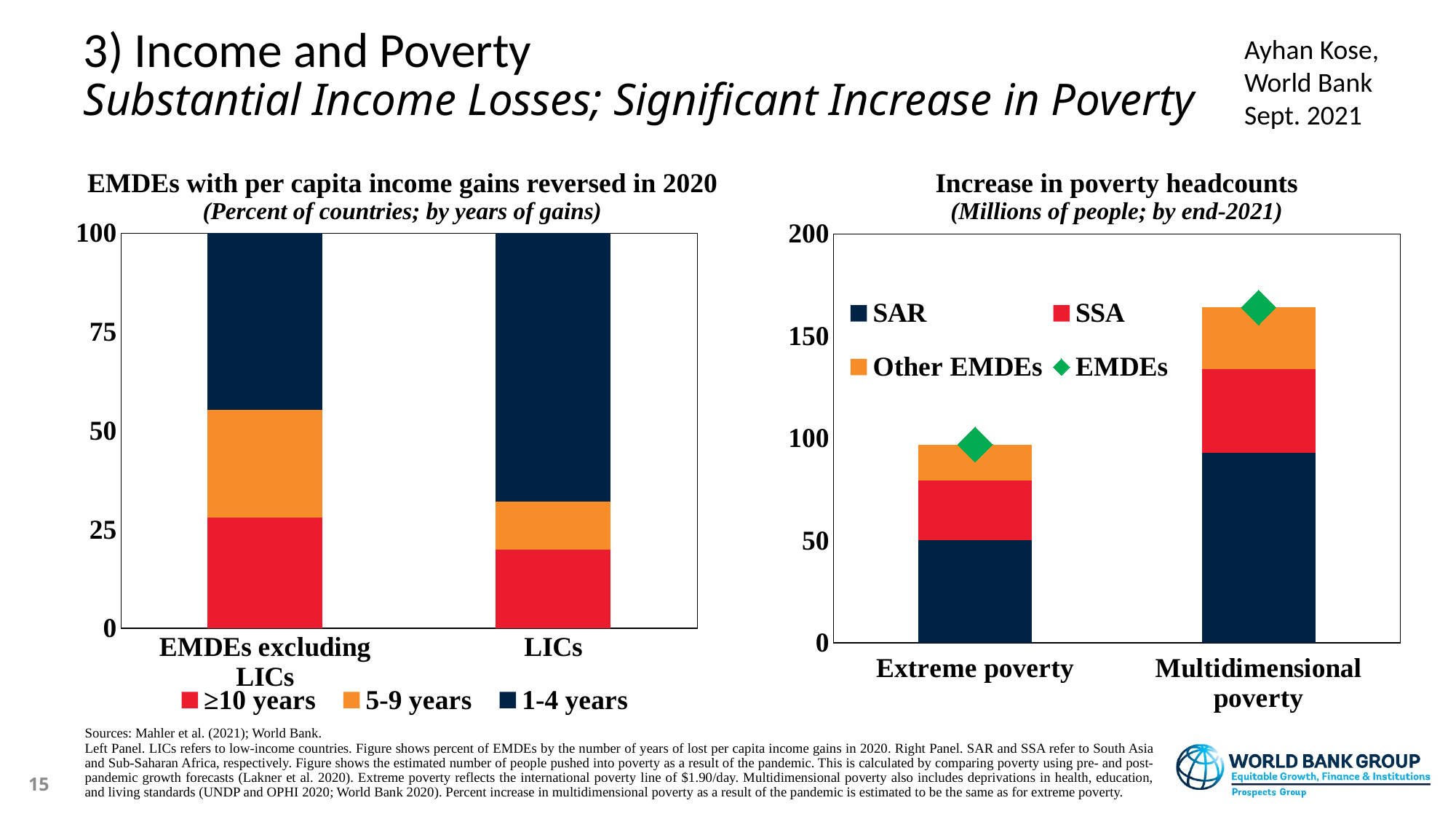
How many series does the legend of the left chart list? 3 In the right chart, which category has the higher total, Extreme poverty or Multidimensional poverty? Multidimensional poverty How many entries does the legend of the right chart list? 4 In the left chart, is the '≥10 years' value for LICs greater or less than 25? less In the left chart, is the top of the '5-9 years' segment for EMDEs excluding LICs greater or less than 50? greater What is the subtitle (units) of the right chart, 'Increase in poverty headcounts'? Millions of people; by end-2021 In the right chart, is the SAR value for Multidimensional poverty greater or less than 50? greater How many categories are shown on the x axis of the left chart? 2 What kind of chart is the left chart, 'EMDEs with per capita income gains reversed in 2020'? Stacked bar chart In the left chart, which category has the larger '1-4 years' segment, EMDEs excluding LICs or LICs? LICs In the left chart, what is the total height of the stacked bar for LICs? 100